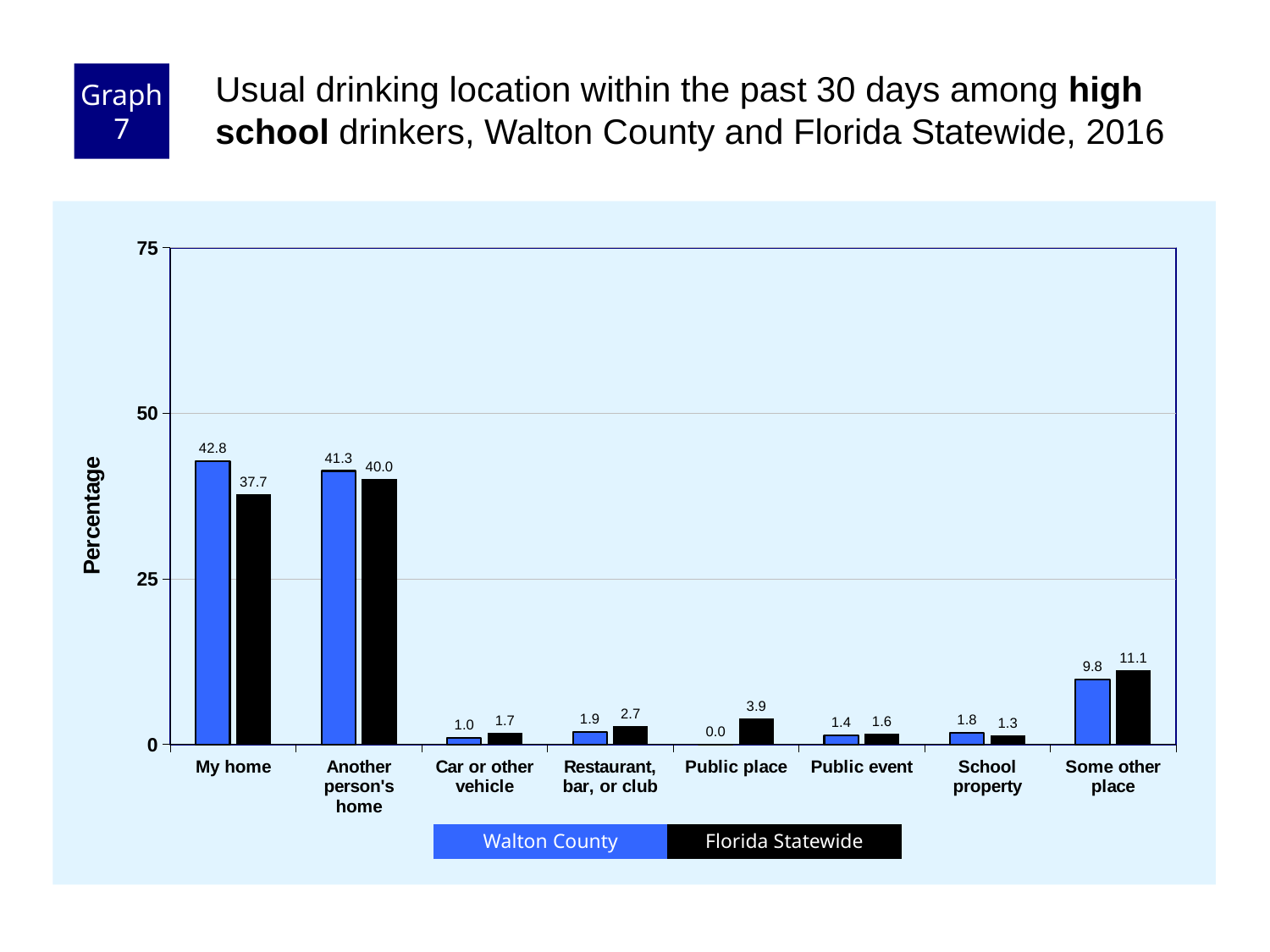
Which category has the highest Walton County value? My home What is the label of the y axis? Percentage What is the Walton County value for "My home"? 42.8 Which is larger for "Restaurant, bar, or club": Walton County or Florida Statewide? Florida Statewide How many series does the legend list? 2 Which category has the lowest Florida Statewide value? School property How many location categories are shown on the x axis? 8 What is the Florida Statewide value for "Some other place"? 11.1 What is the difference between the Walton County and Florida Statewide values for "My home"? 5.1 Is the Florida Statewide value for "Another person's home" greater or less than 25? greater What kind of chart is shown on the slide? Bar chart What is the Walton County value for "Public place"? 0.0